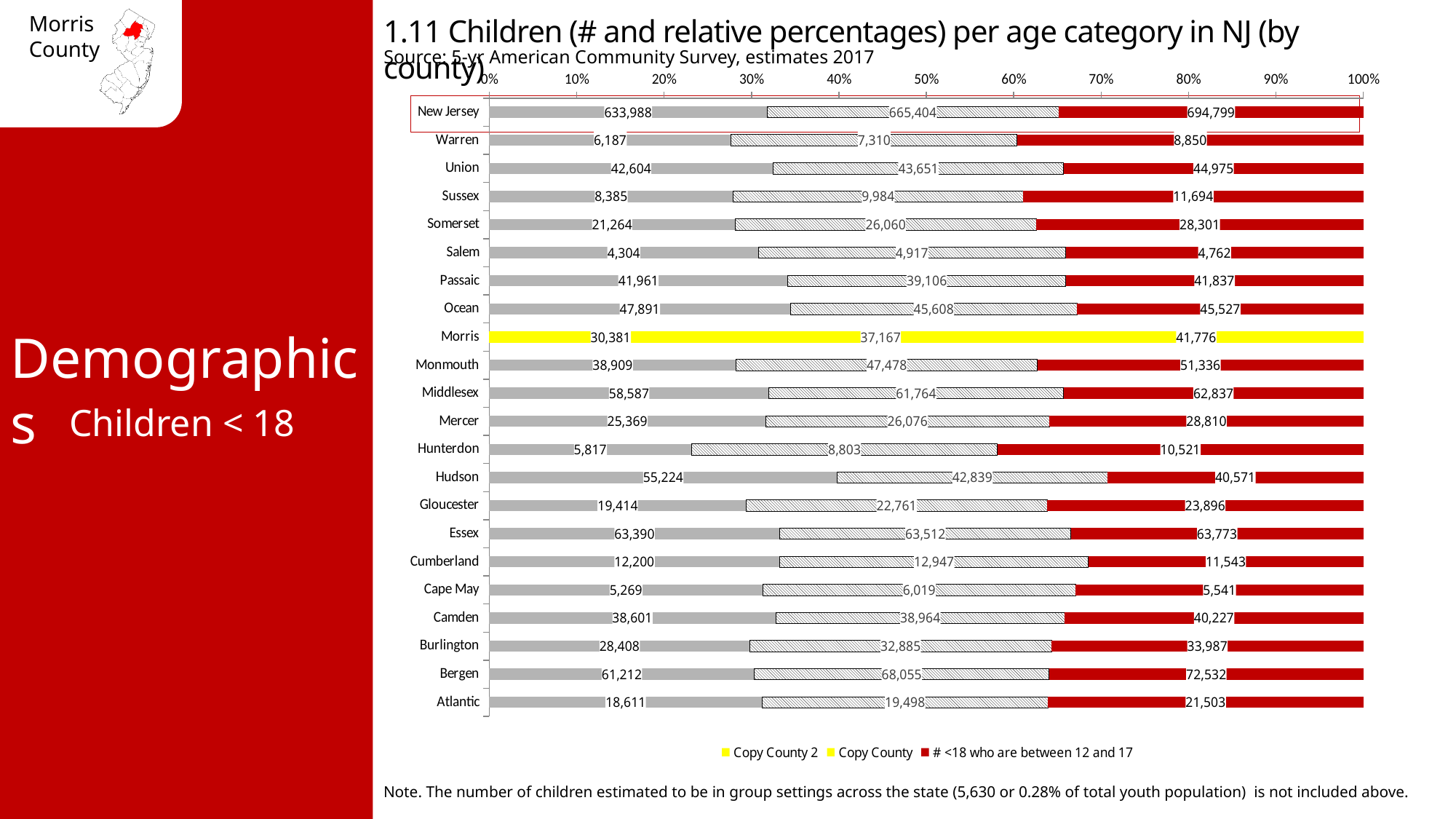
For New Jersey, what is the difference between the red segment value (694,799) and the first segment value (633,988)? 60,811 What is the value of the first (leftmost) segment for Hudson? 55,224 What is the value of the red segment (# <18 who are between 12 and 17) for Morris? 41,776 What is the total of the three segment values shown for Morris? 109,324 How many series does the chart legend list? 3 What kind of chart is shown on the slide? Stacked bar chart How many categories (New Jersey plus counties) are listed on the vertical axis of the chart? 22 Which has the larger first-segment value, Hudson or Essex? Essex What is the value of the first (leftmost) segment for New Jersey? 633,988 Which county's bar is highlighted in yellow on the chart? Morris Among the counties (excluding New Jersey), which has the largest red segment value (# <18 who are between 12 and 17)? Bergen Is the first (leftmost) segment for Hunterdon greater or less than 30% of its bar? less